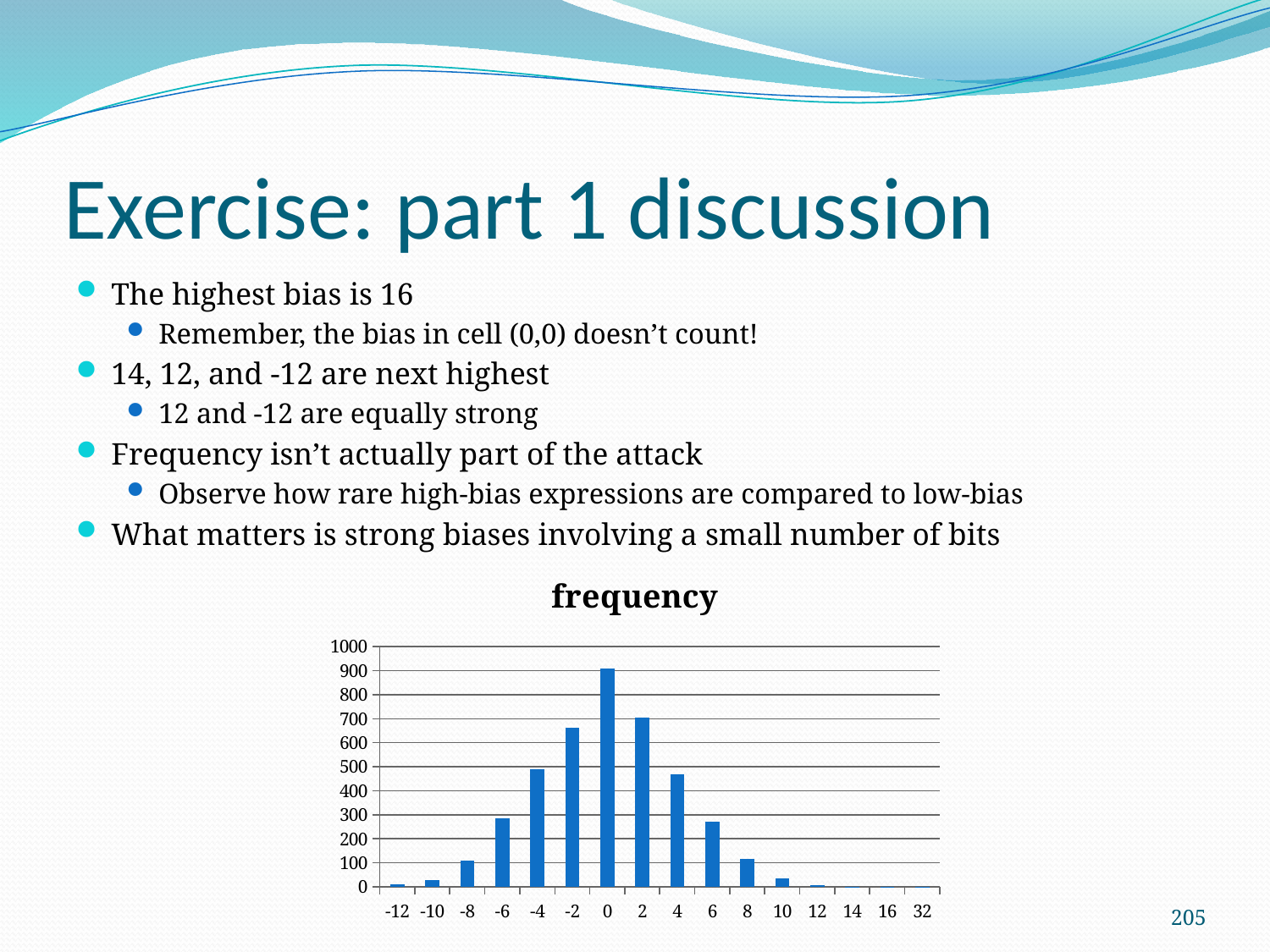
Which is larger, the value for -2 or the value for 2? 2 Is the value for 0 greater or less than 800? greater Is the value for -2 greater or less than 600? greater Is the value for -6 greater or less than 200? greater What kind of chart is shown on the slide? bar chart Do the values rise or fall along the x axis from 0 to 32? fall What is the title of the chart? frequency How many categories are shown on the x axis of the chart? 16 Which category has the highest bar in the chart? 0 Which is larger, the value for -4 or the value for 4? -4